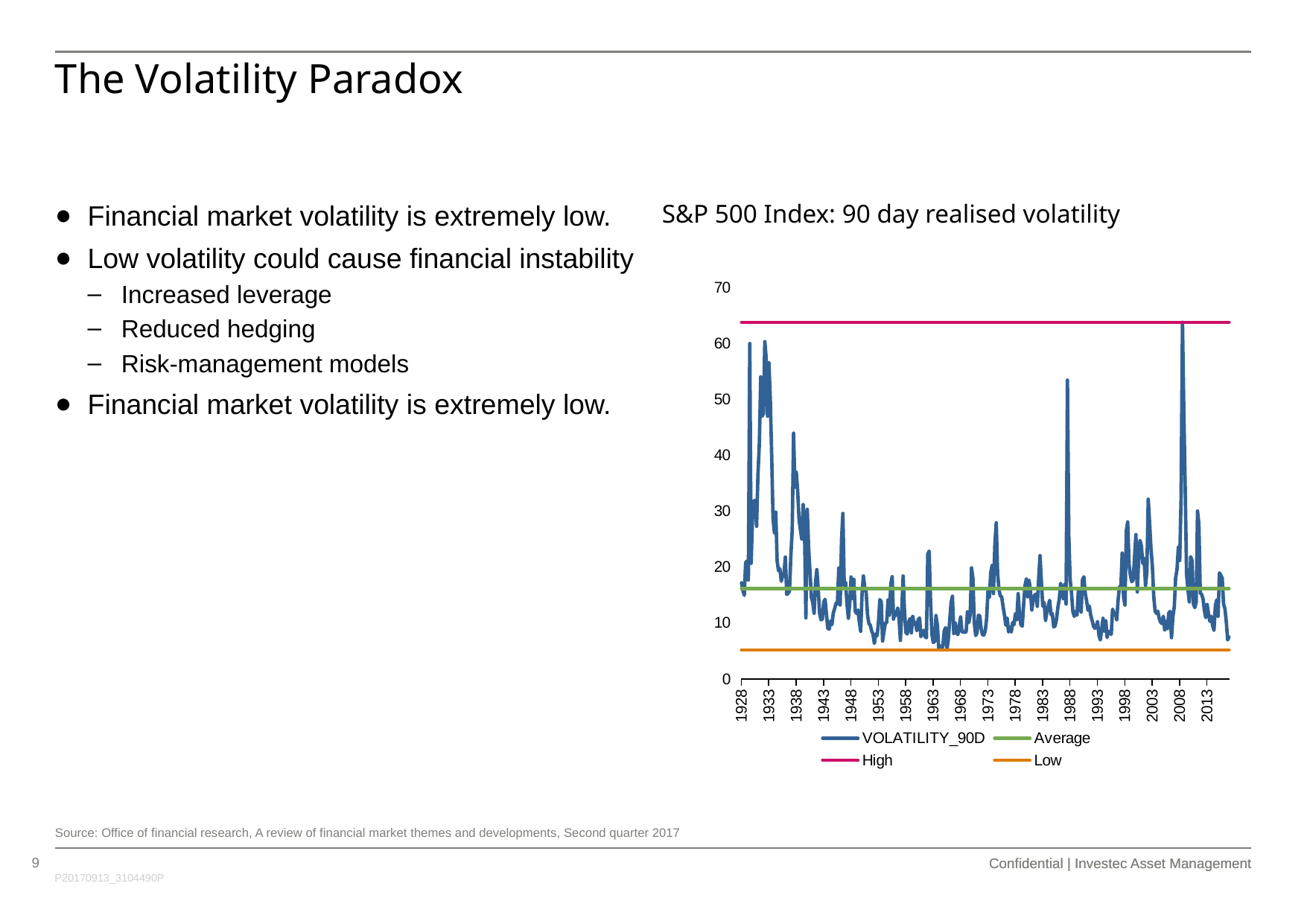
Is the value of the Average line greater or less than 20? less What kind of chart is shown on the slide? Line chart How many year labels are shown on the chart's horizontal axis? 18 What is the highest value shown on the chart's vertical axis? 70 Which series is drawn in blue in the chart? VOLATILITY_90D Is the spike in VOLATILITY_90D around 1988 greater or less than 50? greater Is the value of the Low line greater or less than 10? less How many series does the chart's legend list? 4 What is the title of the chart? S&P 500 Index: 90 day realised volatility